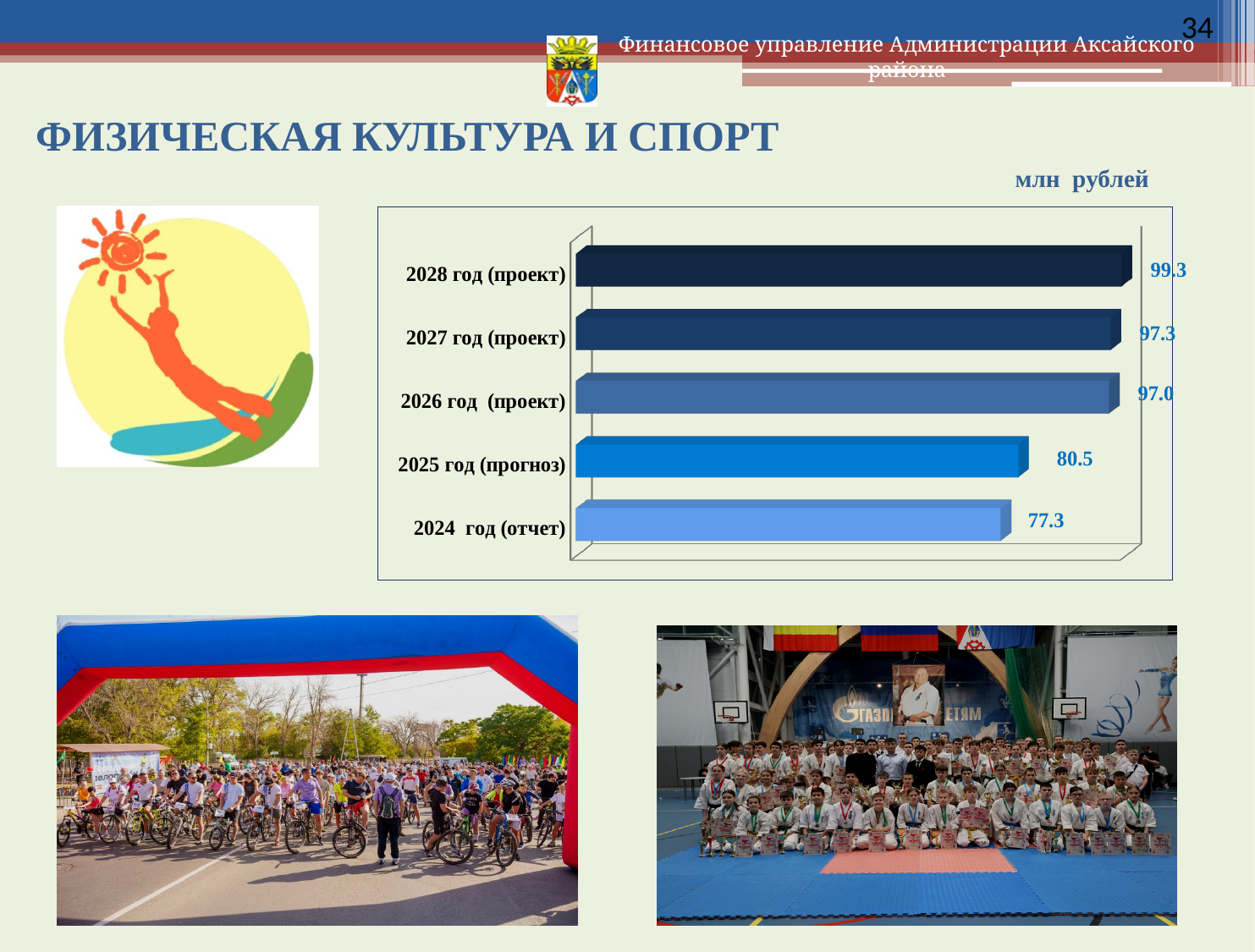
What is the difference between the values for 2026 год (проект) and 2025 год (прогноз)? 16.5 Which category has the lowest value? 2024 год (отчет) Which is larger, the value for 2025 год (прогноз) or the value for 2027 год (проект)? 2027 год (проект) Which category has the highest value? 2028 год (проект) What kind of chart is shown on the slide? bar chart What is the value for 2028 год (проект)? 99.3 What unit of measurement is indicated above the chart? млн рублей What is the difference between the values for 2028 год (проект) and 2024 год (отчет)? 22.0 What is the value for 2025 год (прогноз)? 80.5 How many categories are shown in the chart? 5 What is the value for 2026 год (проект)? 97.0 What is the value for 2024 год (отчет)? 77.3